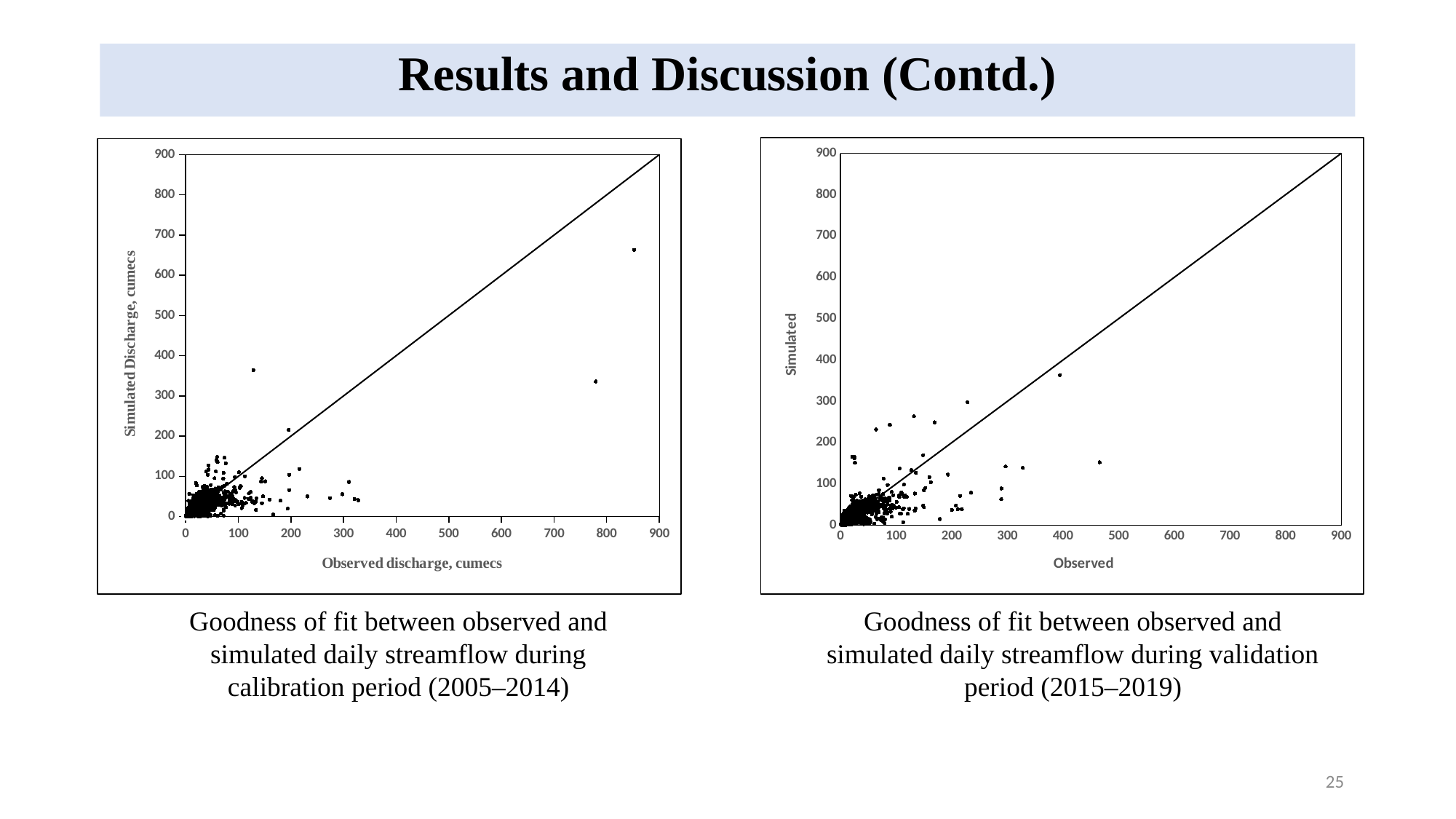
What is the label of the y-axis of the left chart (calibration period)? Simulated Discharge, cumecs What kind of chart is the left chart (calibration period)? scatter chart In the left chart (calibration period), is the simulated discharge of the point at an observed discharge of about 780 cumecs greater or less than 400? less In the left chart (calibration period), which point has the higher simulated discharge: the one at an observed discharge of about 850 cumecs or the one at about 780 cumecs? the one at about 850 cumecs In the left chart (calibration period), is the simulated discharge of the point with the highest observed discharge (around 850 cumecs) greater or less than 600? greater In the left chart (calibration period), is the simulated discharge of the point with the highest observed discharge (around 850 cumecs) greater or less than 700? less What kind of chart is the right chart (validation period)? scatter chart What is the maximum value shown on the x-axis of the right chart (validation period)? 900